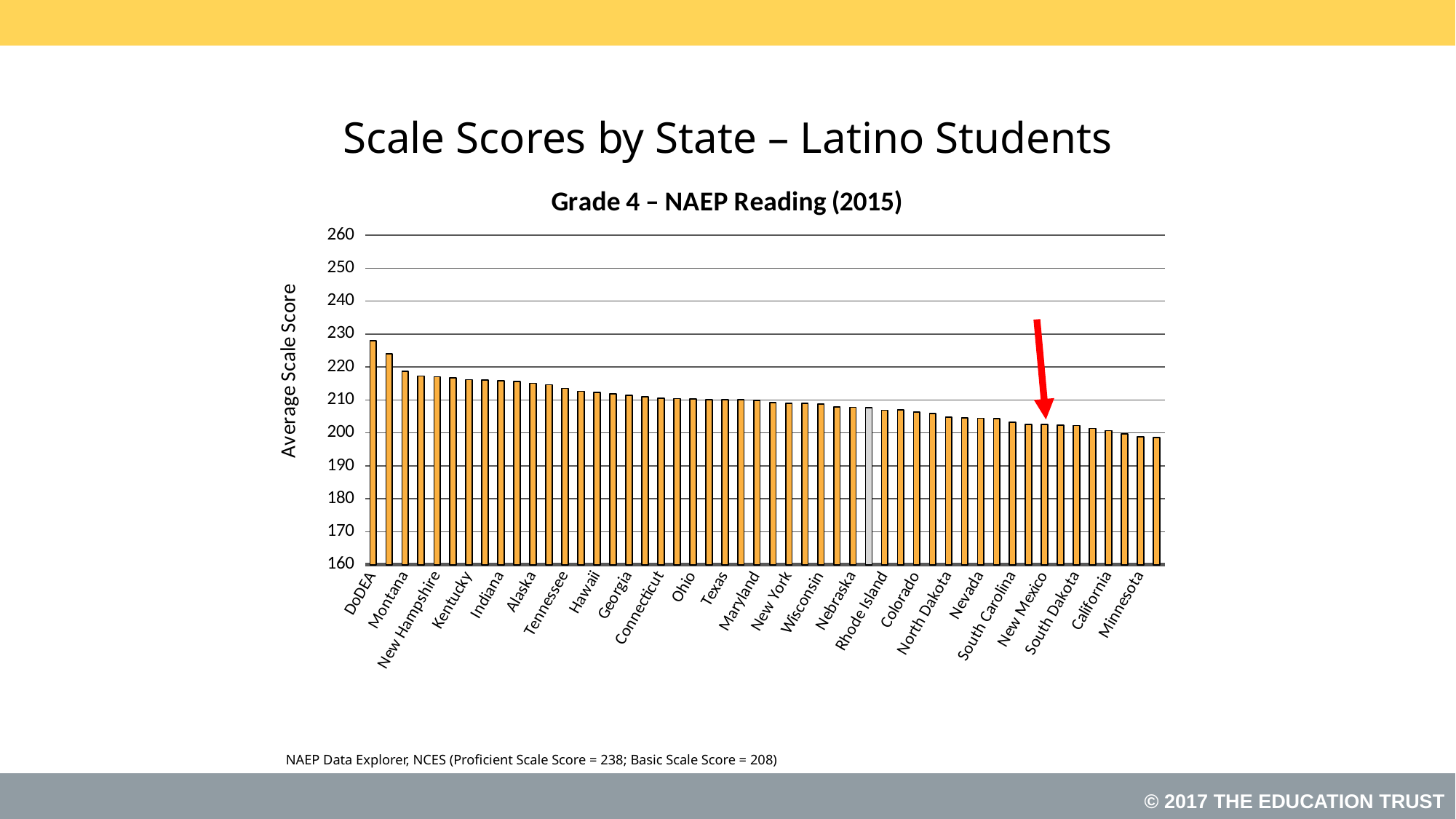
Which state has the highest average scale score? DoDEA Is the value for DoDEA greater or less than 220? greater Which is larger, the value for California or the value for Kentucky? Kentucky Is the value for Minnesota greater or less than 200? less What is the label on the vertical axis? Average Scale Score Which is larger, the value for Montana or the value for New Mexico? Montana What kind of chart is shown on the slide? bar chart What is the title of the chart? Grade 4 – NAEP Reading (2015) Do the values rise or fall moving from left to right along the x axis? fall Is the value for Nevada greater or less than 210? less